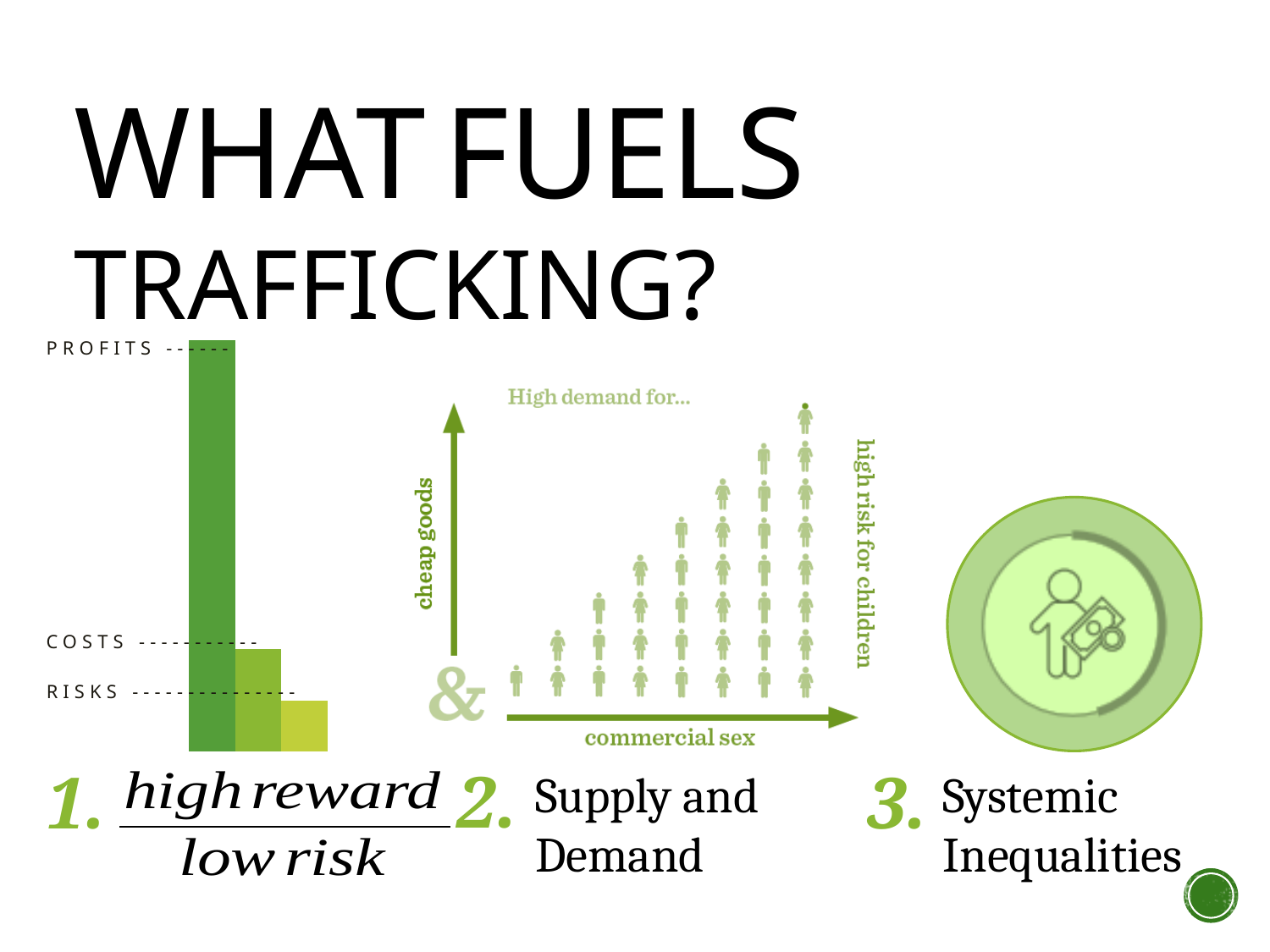
In the middle infographic, what is the label on the horizontal axis? commercial sex In the bar chart on the left, what colour is the PROFITS bar? dark green In the bar chart on the left, which category has the shortest bar? RISKS What are the three categories labelled in the bar chart on the left, from top to bottom? PROFITS, COSTS, RISKS In the bar chart on the left, which category has the tallest bar? PROFITS In the bar chart on the left, do the bars rise or fall from left to right? fall In the middle infographic, what is the label on the vertical axis? cheap goods How many bars does the bar chart on the left of the slide have? 3 In the bar chart on the left, which is larger, COSTS or RISKS? COSTS What kind of chart is shown on the left of the slide, under the title? bar chart In the bar chart on the left, which is larger, PROFITS or COSTS? PROFITS